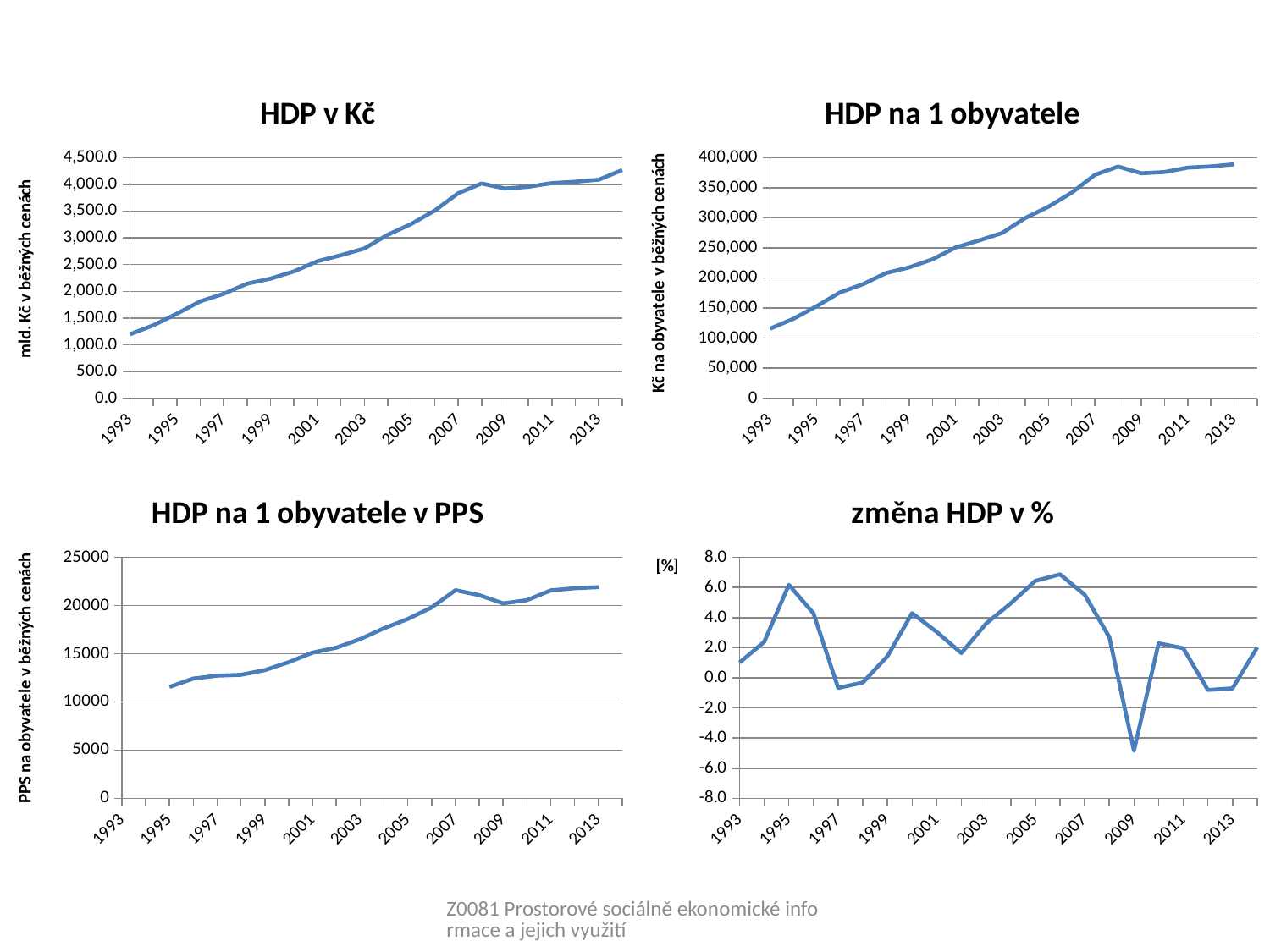
In the 'HDP v Kč' chart, is the value for 2013 greater or less than 3,500.0? greater In the 'HDP na 1 obyvatele' chart, is the value for 1993 greater or less than 150,000? less In the 'HDP v Kč' chart, do the values generally rise or fall from 1993 to 2013? rise In the 'HDP na 1 obyvatele v PPS' chart, is the value for 2007 greater or less than 20000? greater How many charts are shown on the slide? 4 What kind of chart is the 'HDP v Kč' chart? line chart In the 'HDP v Kč' chart, which is larger, the value for 1993 or the value for 2013? 2013 In the 'změna HDP v %' chart, which year has the lowest value? 2009